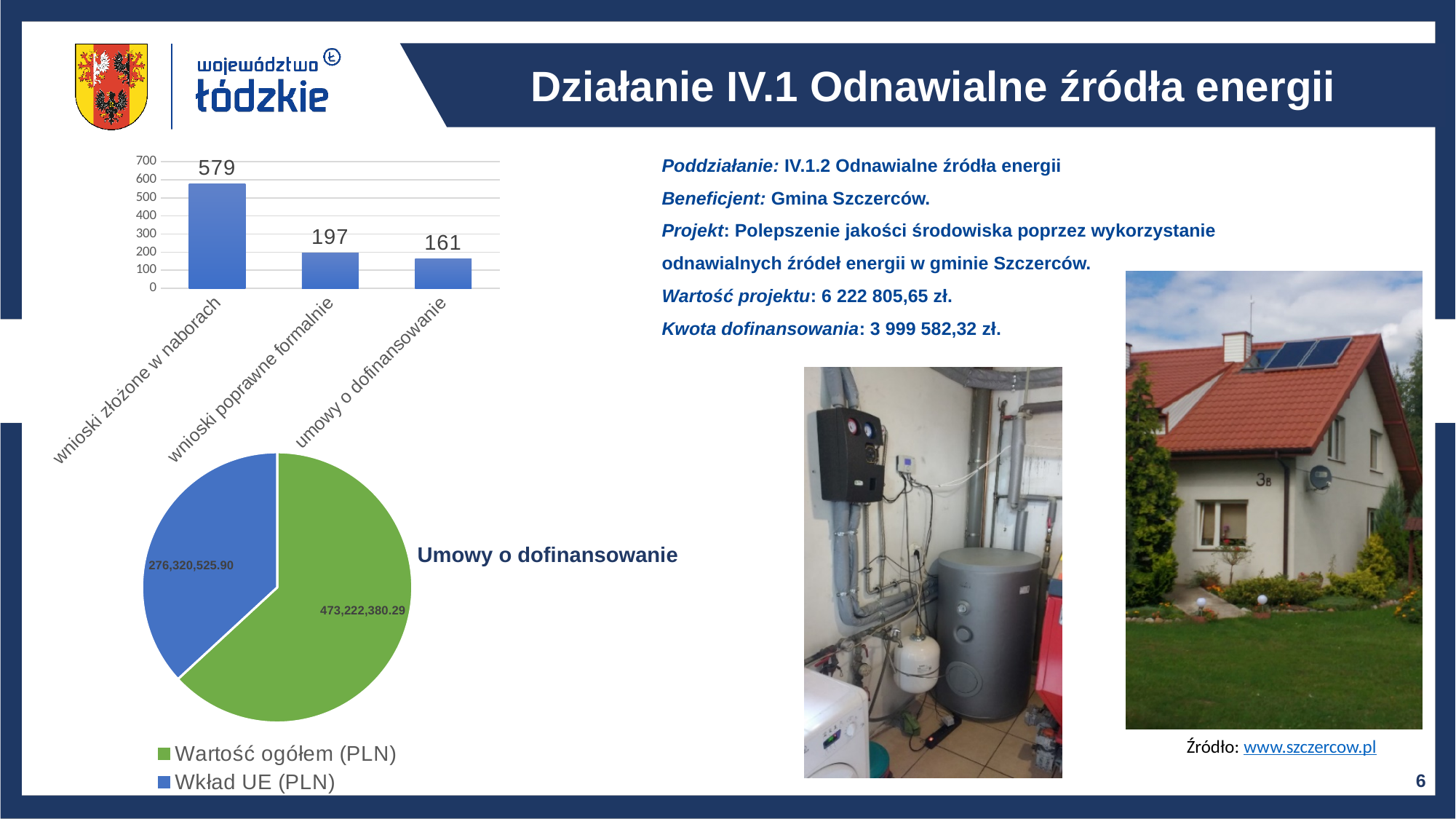
In the bar chart at the top left, what is the value for "umowy o dofinansowanie"? 161 In the pie chart "Umowy o dofinansowanie", what is the value for "Wkład UE (PLN)"? 276,320,525.90 In the bar chart at the top left, what is the difference between "wnioski złożone w naborach" and "wnioski poprawne formalnie"? 382 In the bar chart at the top left, what is the value for "wnioski poprawne formalnie"? 197 In the pie chart "Umowy o dofinansowanie", what is the value for "Wartość ogółem (PLN)"? 473,222,380.29 What kind of chart is the chart at the top left of the slide? bar chart In the bar chart at the top left, do the values rise or fall from left to right? fall In the bar chart at the top left, how many categories are shown? 3 In the pie chart "Umowy o dofinansowanie", which colour represents "Wkład UE (PLN)"? blue In the bar chart at the top left, which category has the lowest value? umowy o dofinansowanie In the bar chart at the top left, what is the value for "wnioski złożone w naborach"? 579 In the bar chart at the top left, which category has the highest value? wnioski złożone w naborach